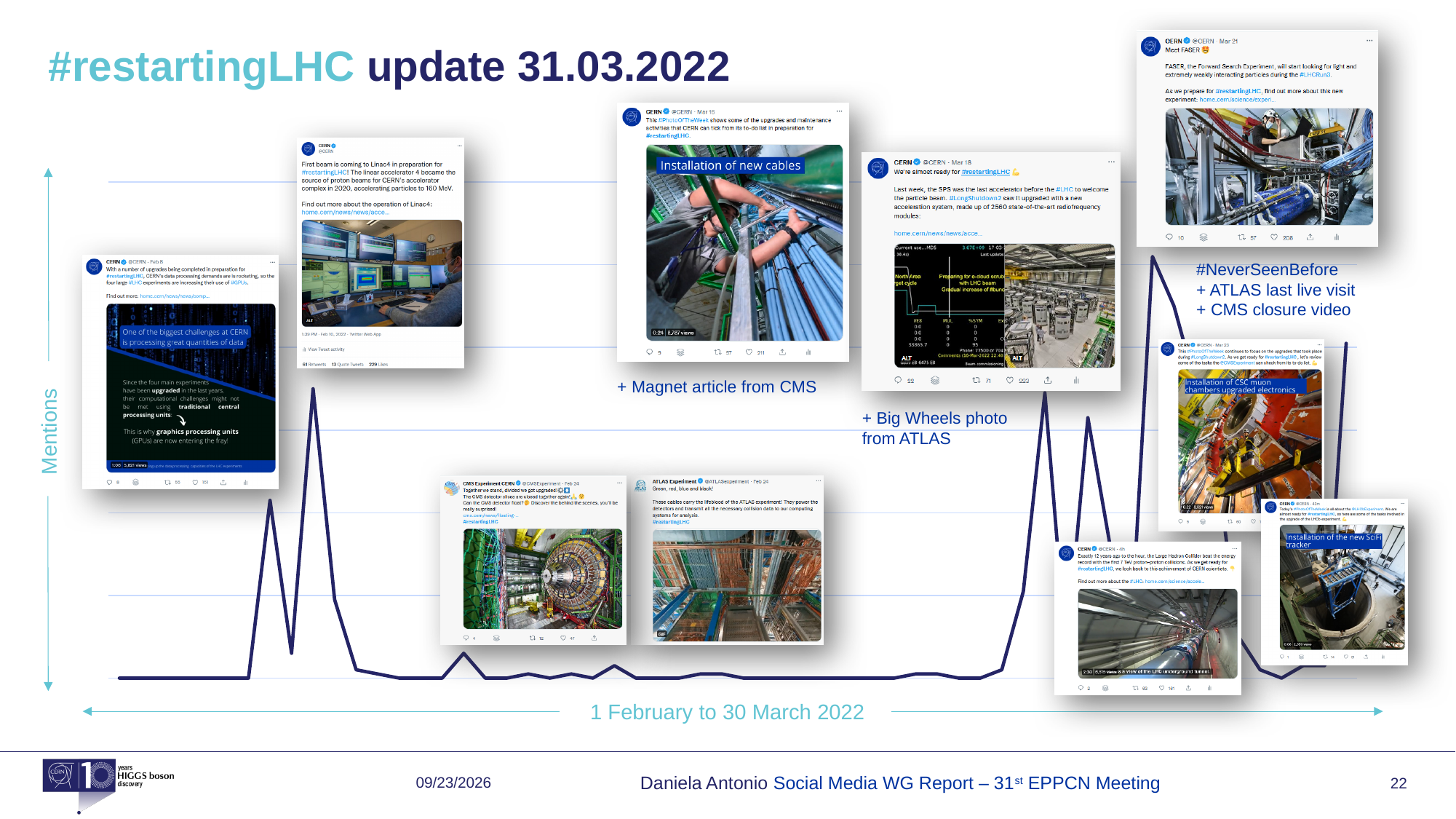
Which is higher: the peak in mentions in mid-February or the peak in late March? late March Does the highest peak of the mentions line occur near the start or near the end of the period? near the end Is the mentions line higher at the end of the period than at the start? yes What kind of chart is shown on the slide? line chart How many lines (series) are plotted on the chart? 1 Is the mentions line at its lowest level near the start of the period or near the end? near the start What period does the horizontal axis of the chart cover? 1 February to 30 March 2022 What is the label on the vertical axis of the chart? Mentions